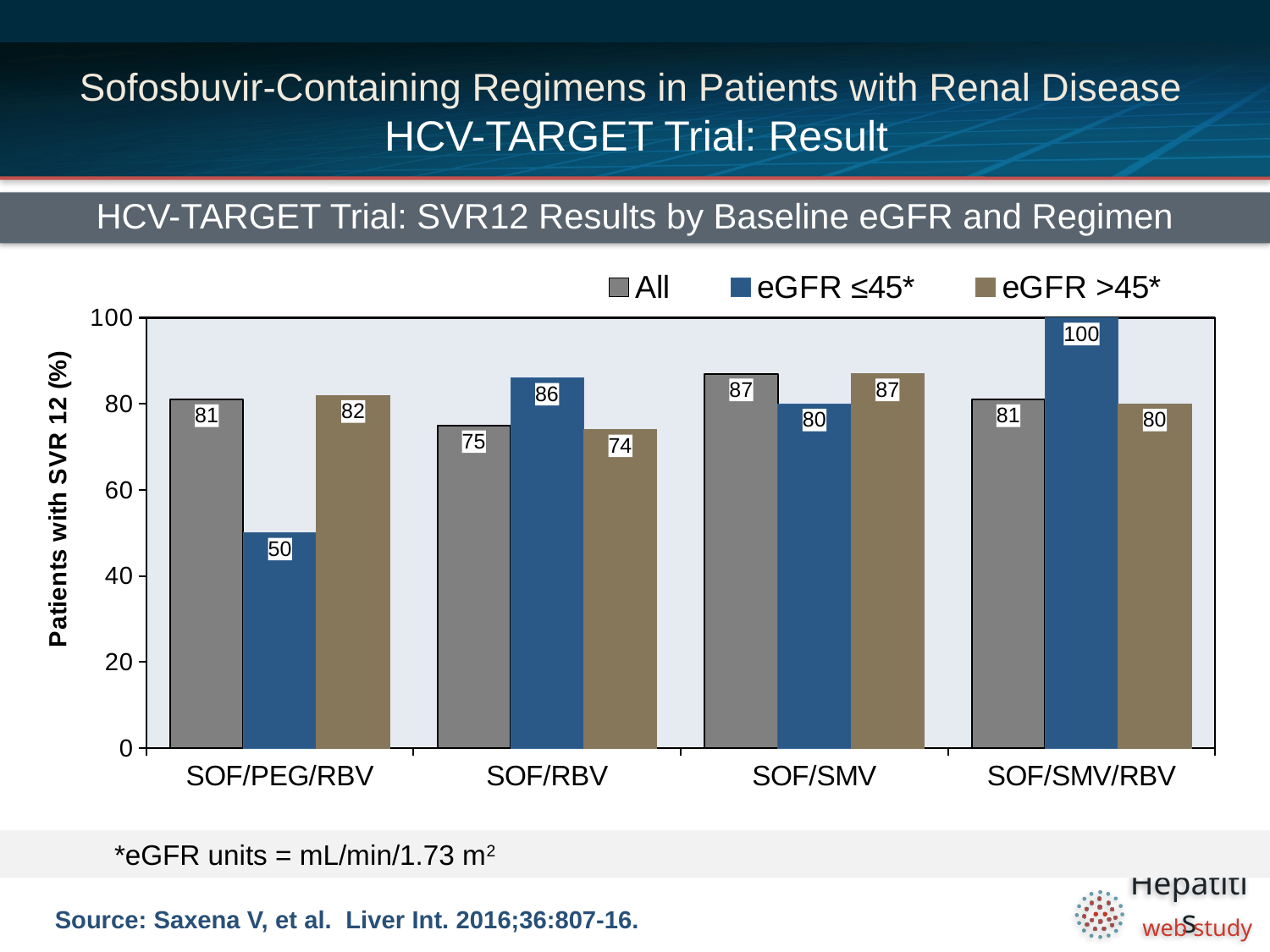
What is the y-axis label of the chart? Patients with SVR 12 (%) How many regimen categories are shown on the x axis? 4 Is the value for eGFR ≤45* in the SOF/PEG/RBV group greater or less than 60? less What kind of chart is shown on the slide? bar chart What is the SVR12 value for the All series in the SOF/SMV group? 87 What is the difference between the eGFR >45* and eGFR ≤45* values in the SOF/PEG/RBV group? 32 Which regimen has the highest value for the eGFR ≤45* series? SOF/SMV/RBV What is the SVR12 value for the eGFR ≤45* series in the SOF/PEG/RBV group? 50 How many series does the legend list? 3 What is the SVR12 value for the eGFR >45* series in the SOF/RBV group? 74 Which regimen has the lowest value for the All series? SOF/RBV In the SOF/RBV group, which is larger: the eGFR ≤45* value or the eGFR >45* value? eGFR ≤45*